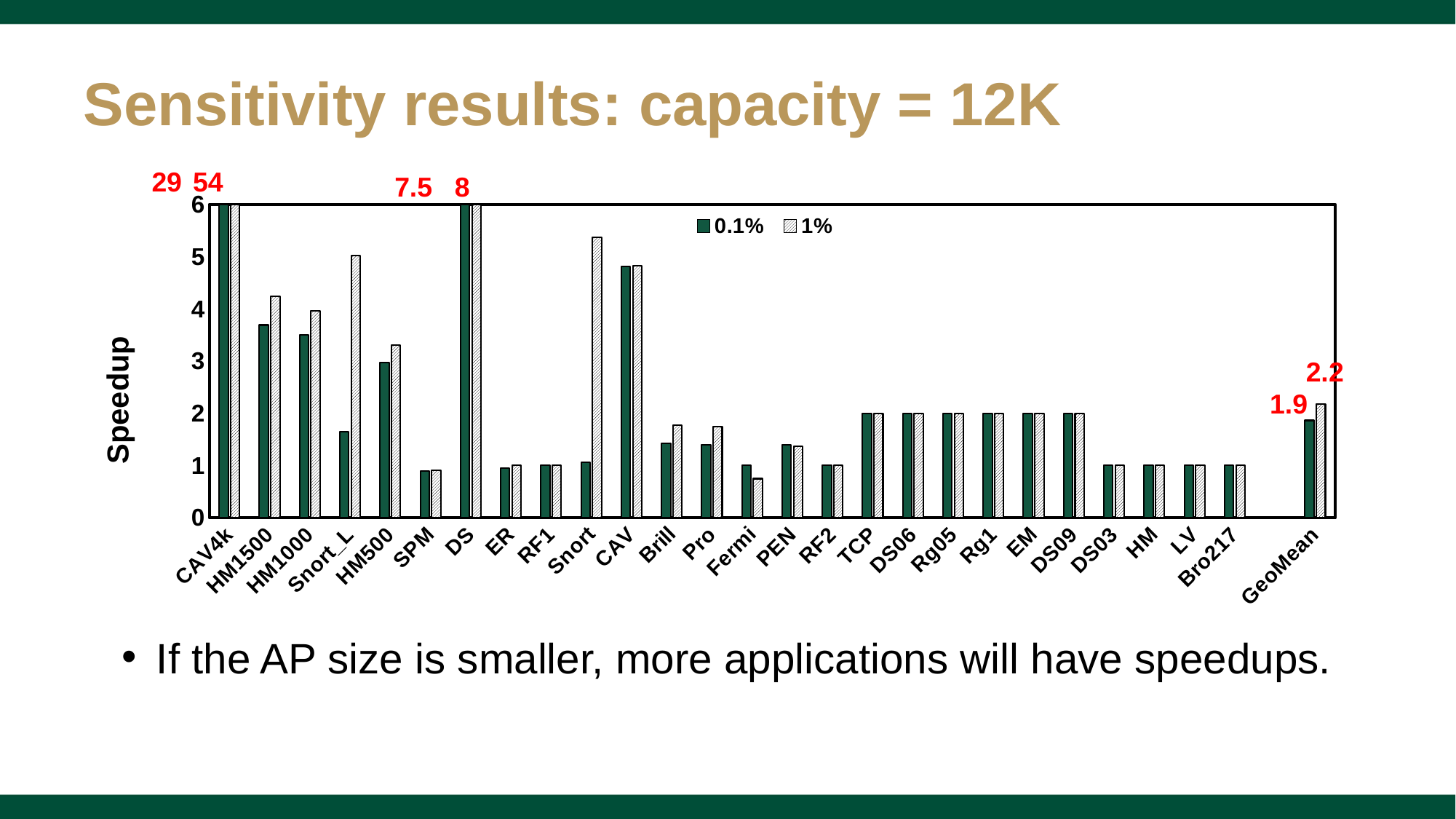
What is the speedup for DS in the 1% series? 8 For Snort, which series has the larger speedup, 0.1% or 1%? 1% What is the speedup for CAV4k in the 0.1% series? 29 What is the difference between the 1% and 0.1% speedups for CAV4k? 25 What is the speedup for CAV4k in the 1% series? 54 How many series does the legend list? 2 Which category has the highest speedup in the 1% series? CAV4k What is the label on the y axis of the chart? Speedup What is the difference between the 1% and 0.1% GeoMean speedups? 0.3 What is the GeoMean speedup for the 0.1% series? 1.9 What kind of chart is shown on the slide? Bar chart Is the 1% speedup for Snort greater or less than 5? greater